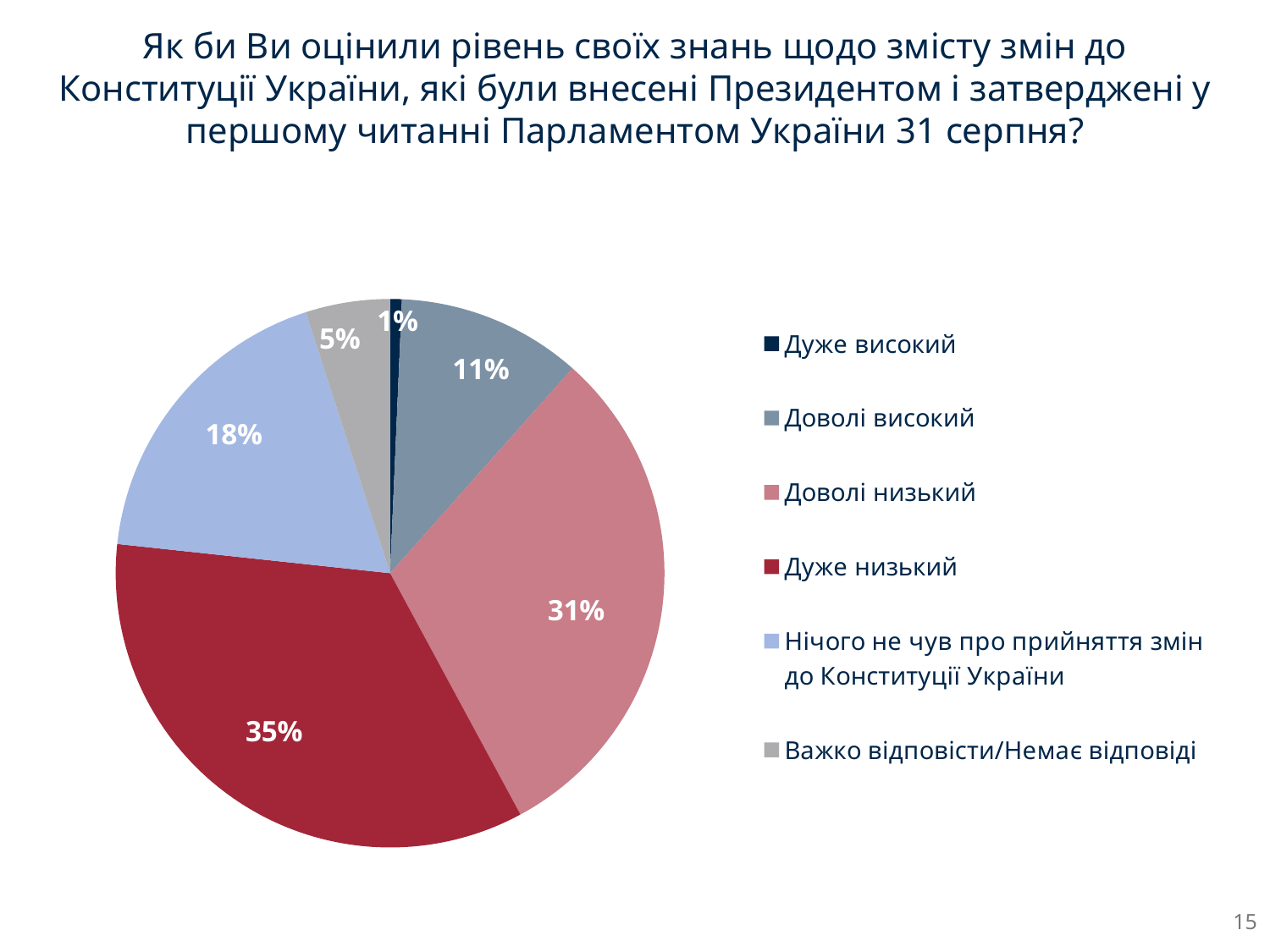
Which is larger: the share for "Нічого не чув про прийняття змін до Конституції України" or the share for "Доволі високий"? Нічого не чув про прийняття змін до Конституції України What kind of chart is shown on the slide? Pie chart What share of respondents answered "Доволі низький"? 31% Which category has the smallest slice of the pie? Дуже високий What colour is the slice for "Дуже низький"? Dark red How many categories does the pie chart show? 6 What share of respondents answered "Дуже низький"? 35% Which category has the largest slice of the pie? Дуже низький What share of respondents answered "Доволі високий"? 11% What share of respondents answered "Важко відповісти/Немає відповіді"? 5% What share of respondents answered "Нічого не чув про прийняття змін до Конституції України"? 18% What is the difference between the shares for "Дуже низький" and "Доволі низький"? 4 percentage points